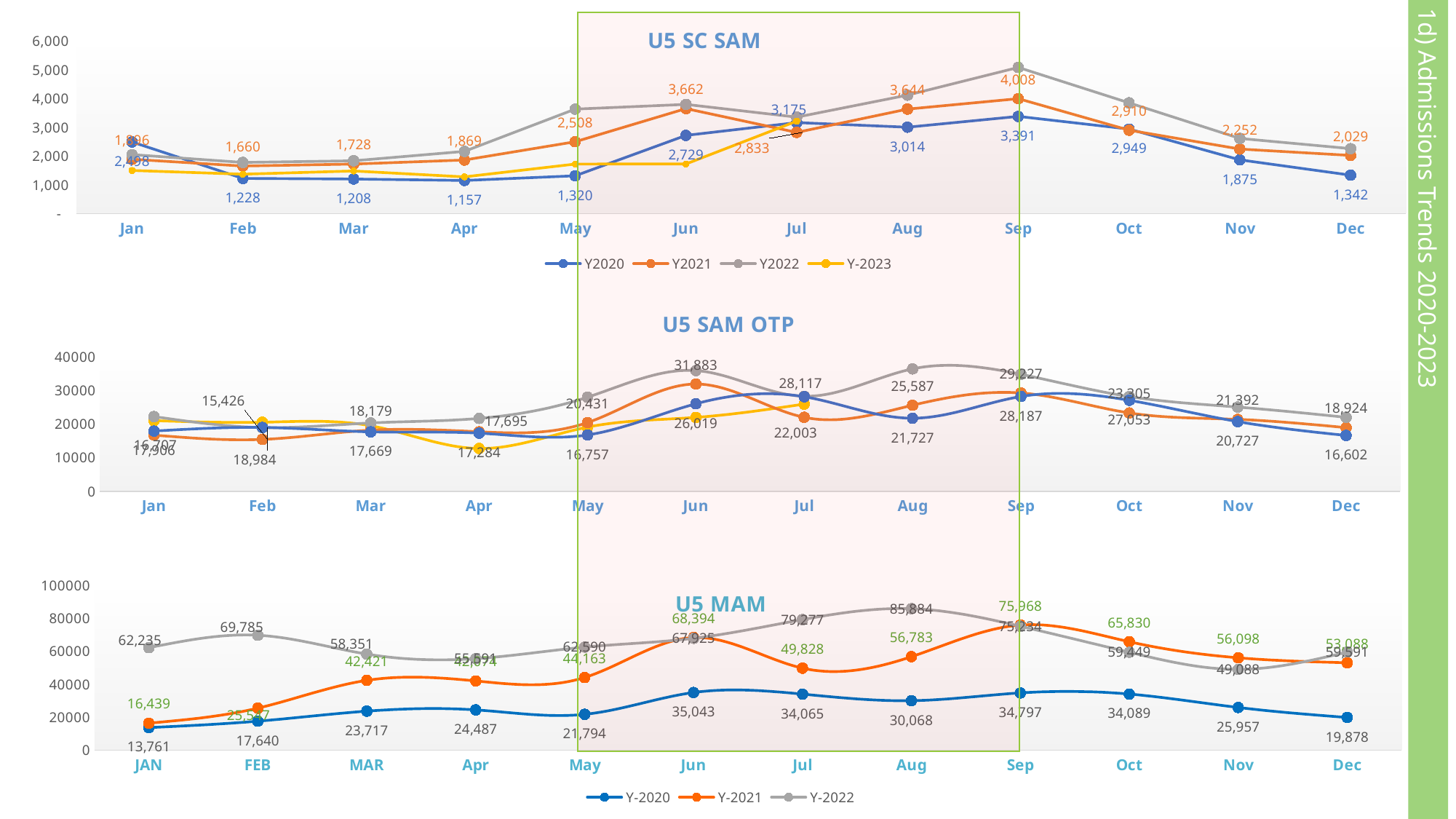
In the U5 SC SAM chart, what is the Y2021 value for Sep? 4,008 How many series does the legend of the U5 SC SAM chart list? 4 In the U5 MAM chart, what is the difference between the Y-2022 and Y-2020 values for Aug? 55,816 How many series does the legend of the U5 MAM chart list? 3 In the U5 MAM chart, which month has the highest Y-2022 value? Aug What kind of chart is the U5 MAM chart? line chart In the U5 MAM chart, what is the Y-2020 value for JAN? 13,761 In the U5 SC SAM chart, which month has the lowest Y2020 value? Apr In the U5 SC SAM chart, what is the Y2020 value for Apr? 1,157 How many months are plotted along the x axis of the U5 SC SAM chart? 12 In the U5 SC SAM chart, which series has the larger value in Jun, Y2020 or Y2021? Y2021 In the U5 SAM OTP chart, is the Y2022 value for Jun greater or less than 30000? greater